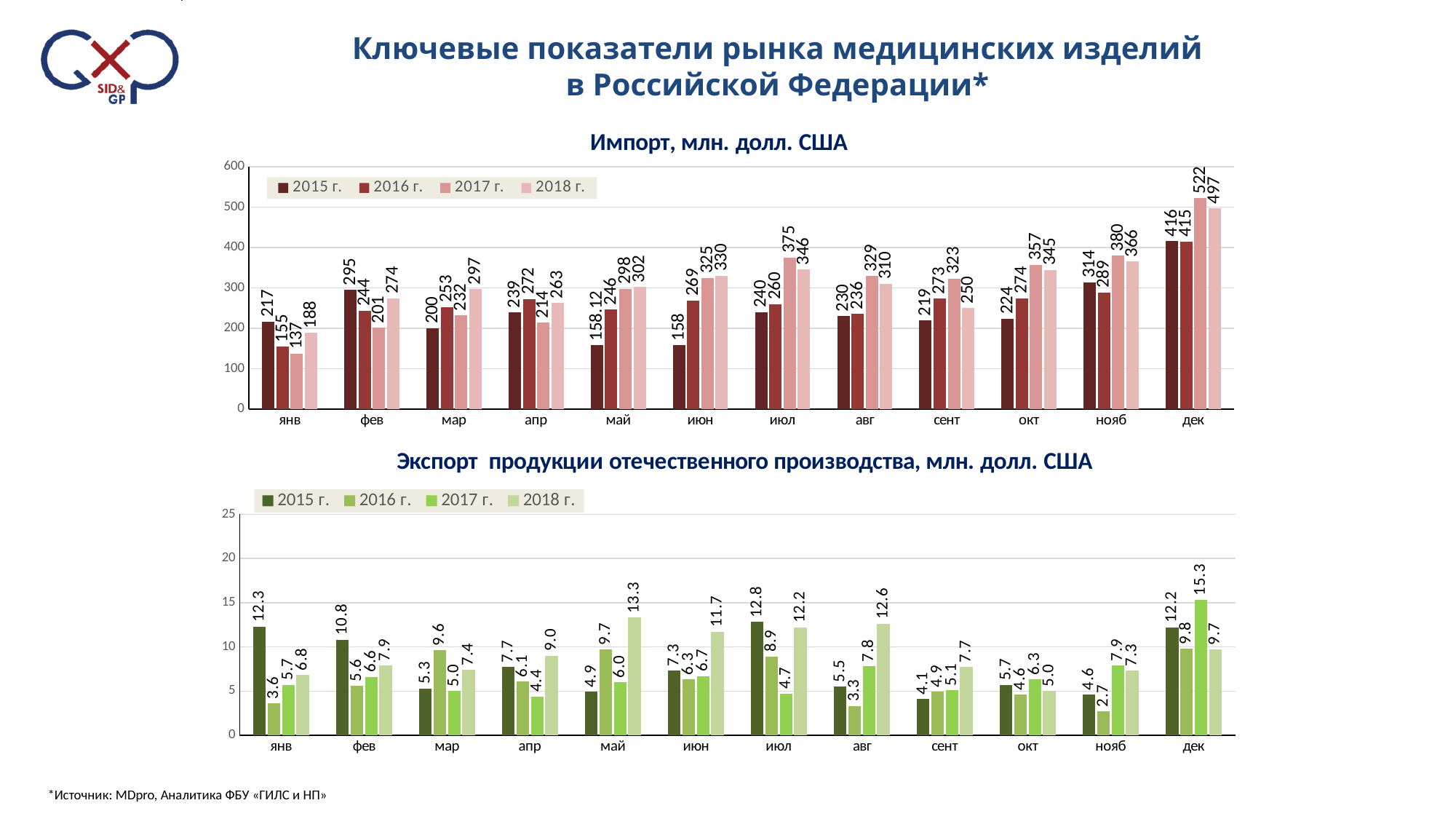
In the import chart (Импорт, млн. долл. США), which month has the lowest value for 2017 г.? янв In the import chart (Импорт, млн. долл. США), which month has the highest value for 2018 г.? дек How many series does the legend of the import chart (Импорт, млн. долл. США) list? 4 How many months are shown on the x axis of the export chart (Экспорт продукции отечественного производства)? 12 In the export chart (Экспорт продукции отечественного производства), which month has the highest value for 2017 г.? дек In the import chart (Импорт, млн. долл. США), what is the value for 2017 г. in дек? 522 In the import chart (Импорт, млн. долл. США), which is larger in сент: the value for 2017 г. or for 2018 г.? 2017 г. In the import chart (Импорт, млн. долл. США), what is the difference between the 2017 г. and 2016 г. values in июл? 115 In the export chart (Экспорт продукции отечественного производства), which month has the lowest value for 2016 г.? нояб In the import chart (Импорт, млн. долл. США), what is the value for 2015 г. in май? 158.12 In the export chart (Экспорт продукции отечественного производства), what is the value for 2018 г. in май? 13.3 In the export chart (Экспорт продукции отечественного производства), what is the difference between the 2015 г. and 2016 г. values in янв? 8.7